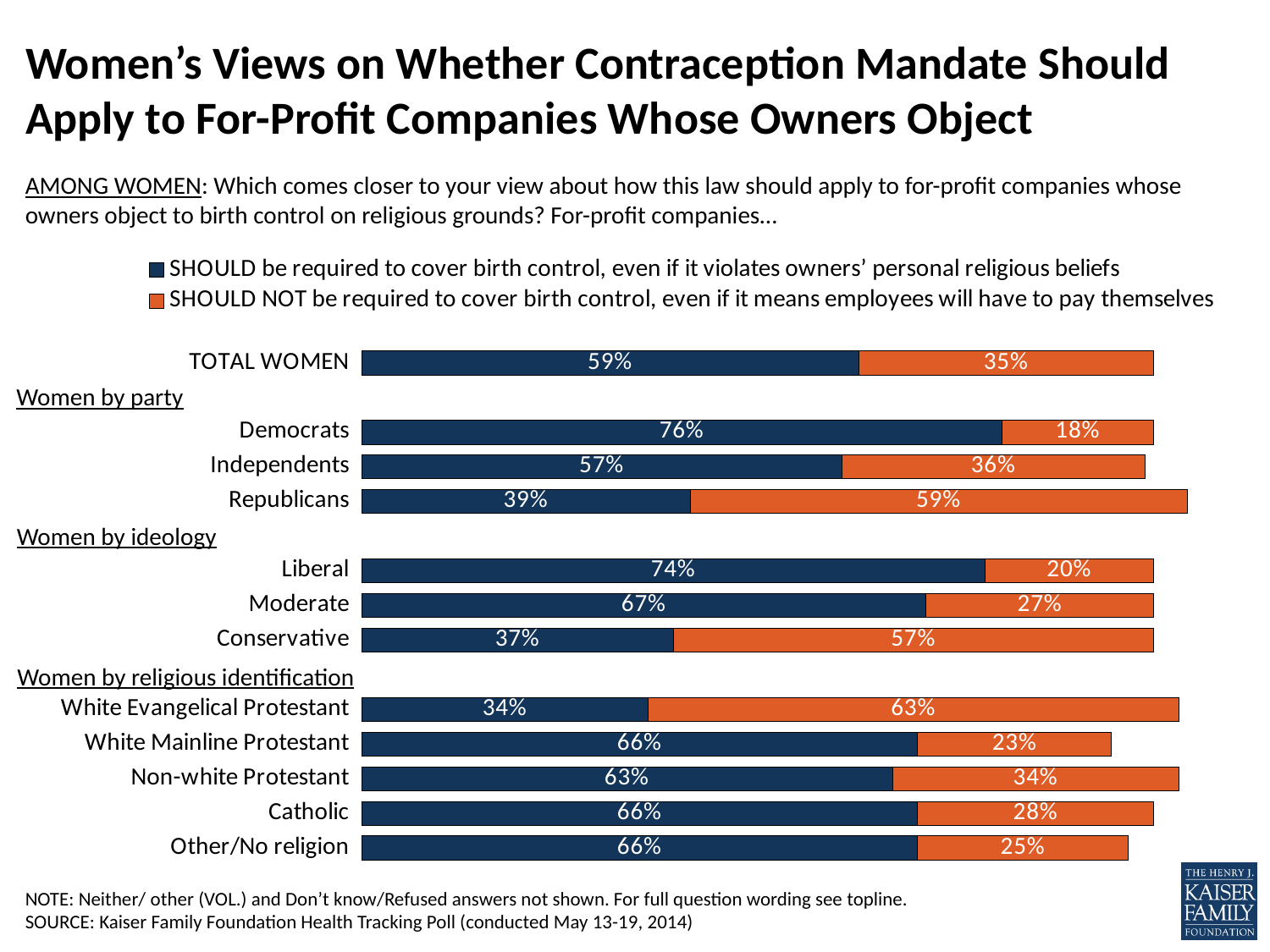
How many series does the legend list? 2 Among Conservative women, which is larger: the share saying companies SHOULD be required or the share saying they SHOULD NOT be required? SHOULD NOT be required What is the difference between the share of Republicans and the share of Democrats saying companies SHOULD be required to cover birth control? 37 percentage points What kind of chart is shown on the slide? Stacked horizontal bar chart How many groups (bars) are shown in the chart? 12 What percentage of Democrats say for-profit companies SHOULD be required to cover birth control? 76% Which group has the lowest share saying companies SHOULD NOT be required to cover birth control? Democrats Which group has the lowest share saying companies SHOULD be required to cover birth control? White Evangelical Protestant What is the combined total of the SHOULD and SHOULD NOT responses for Catholic women? 94% Which group has the highest share saying companies SHOULD be required to cover birth control? Democrats What percentage of White Evangelical Protestant women say for-profit companies SHOULD NOT be required to cover birth control? 63% What percentage of TOTAL WOMEN say for-profit companies SHOULD be required to cover birth control? 59%